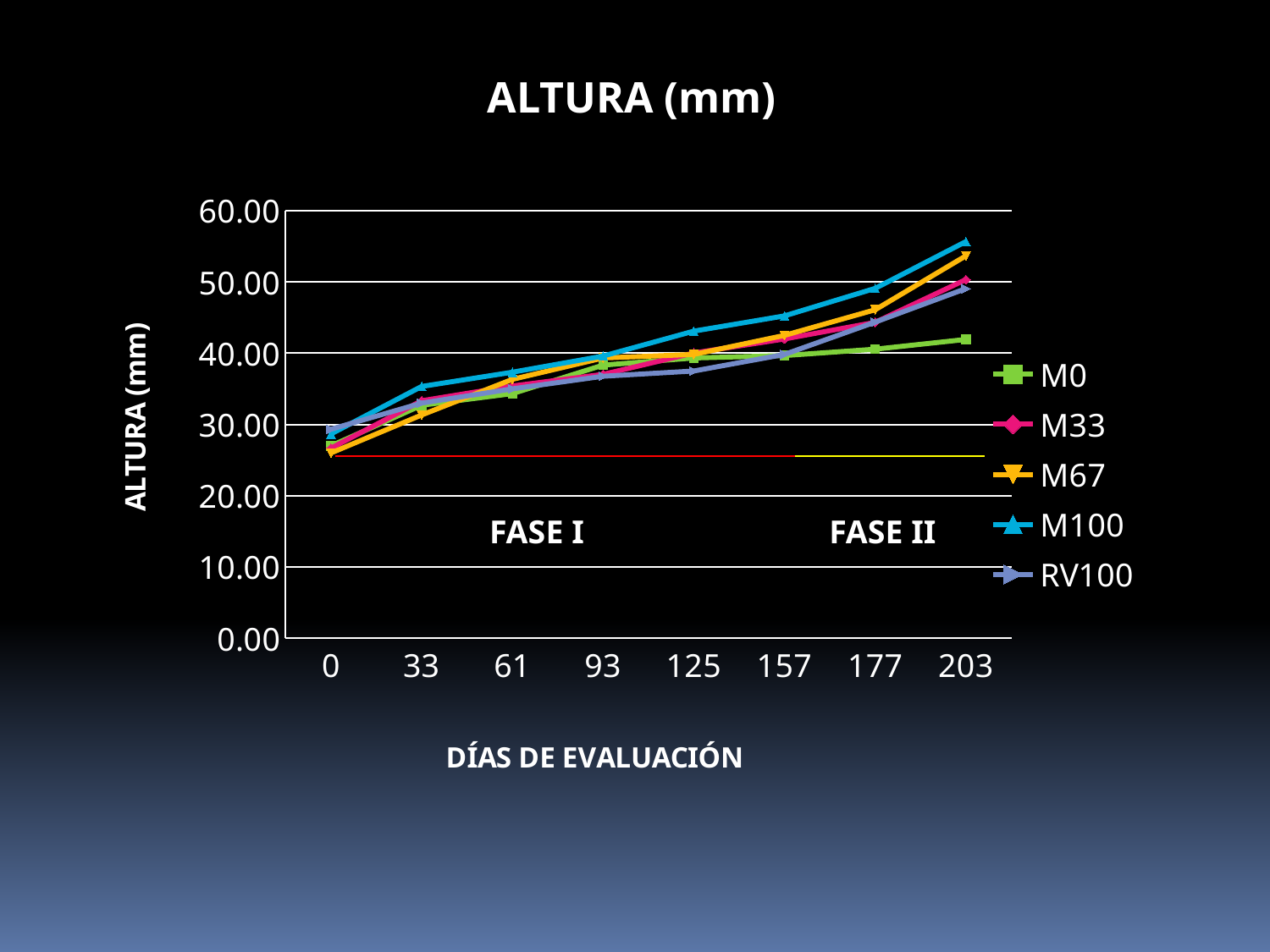
Is the value for RV100 at day 125 greater or less than 40.00? less Which series has the highest value at day 203? M100 What kind of chart is shown on the slide? line chart Is the value for M100 at day 203 greater or less than 50.00? greater Which series has the lowest value at day 203? M0 What is the label of the x axis? DÍAS DE EVALUACIÓN How many series does the legend list? 5 Is the value for M0 at day 203 greater or less than 50.00? less Do the values for M100 rise or fall from day 0 to day 203? rise How many evaluation days (points) are shown on the x axis? 8 Which is larger at day 203, the value for M67 or the value for M0? M67